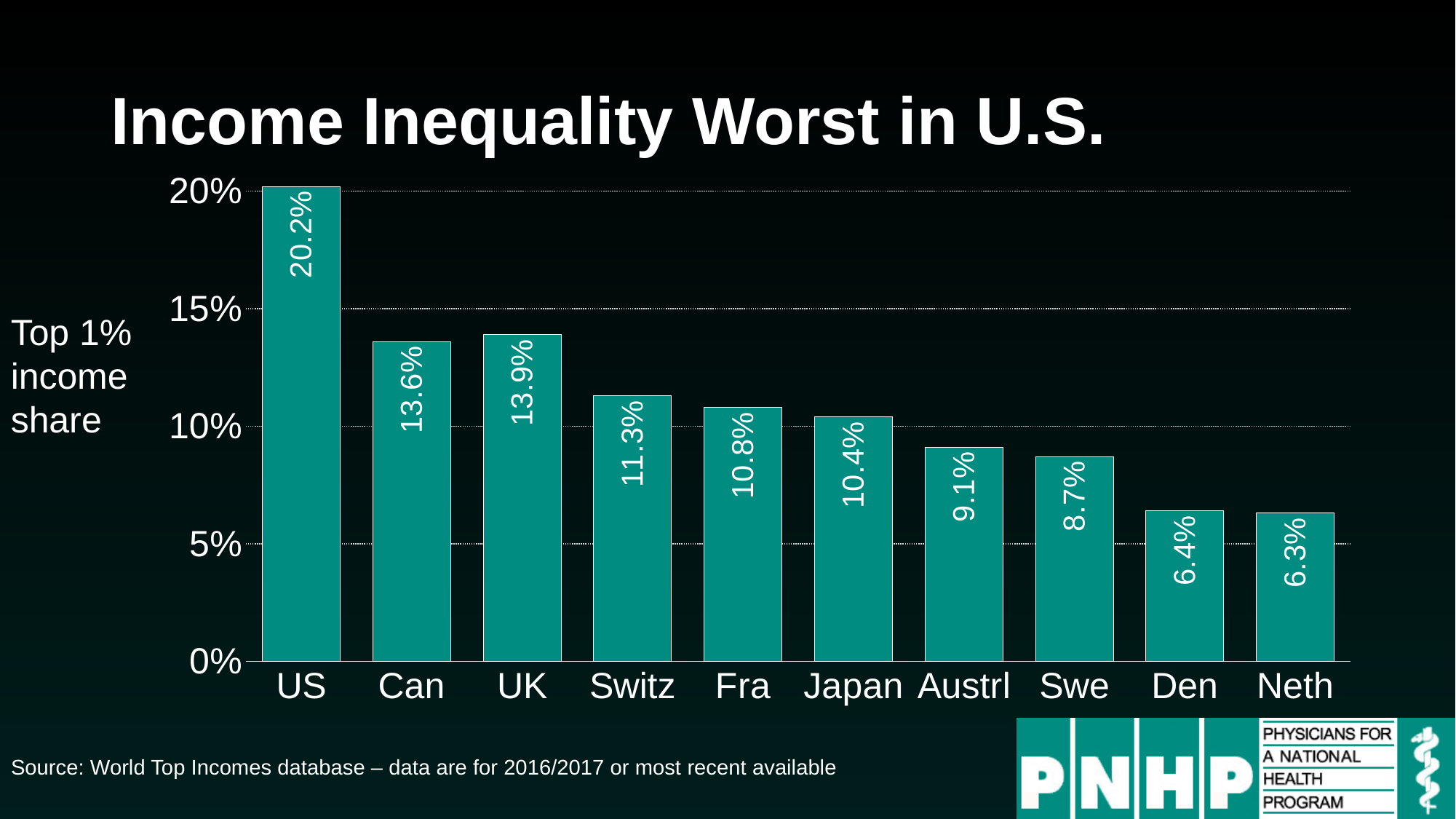
Which country has the lowest top 1% income share? Neth Is the value for Switzerland (Switz) greater or less than 10%? greater Which has a larger top 1% income share, Canada (Can) or the UK? UK How many countries are shown in the chart? 10 Which country has the highest top 1% income share? US What is the difference between the top 1% income share of the US and the UK? 6.3% What kind of chart is shown on the slide? Bar chart What is the top 1% income share for Sweden (Swe)? 8.7% What is the top 1% income share for Japan? 10.4% What does the y-axis of the chart measure? Top 1% income share What is the title of the slide? Income Inequality Worst in U.S. What is the top 1% income share for the US? 20.2%